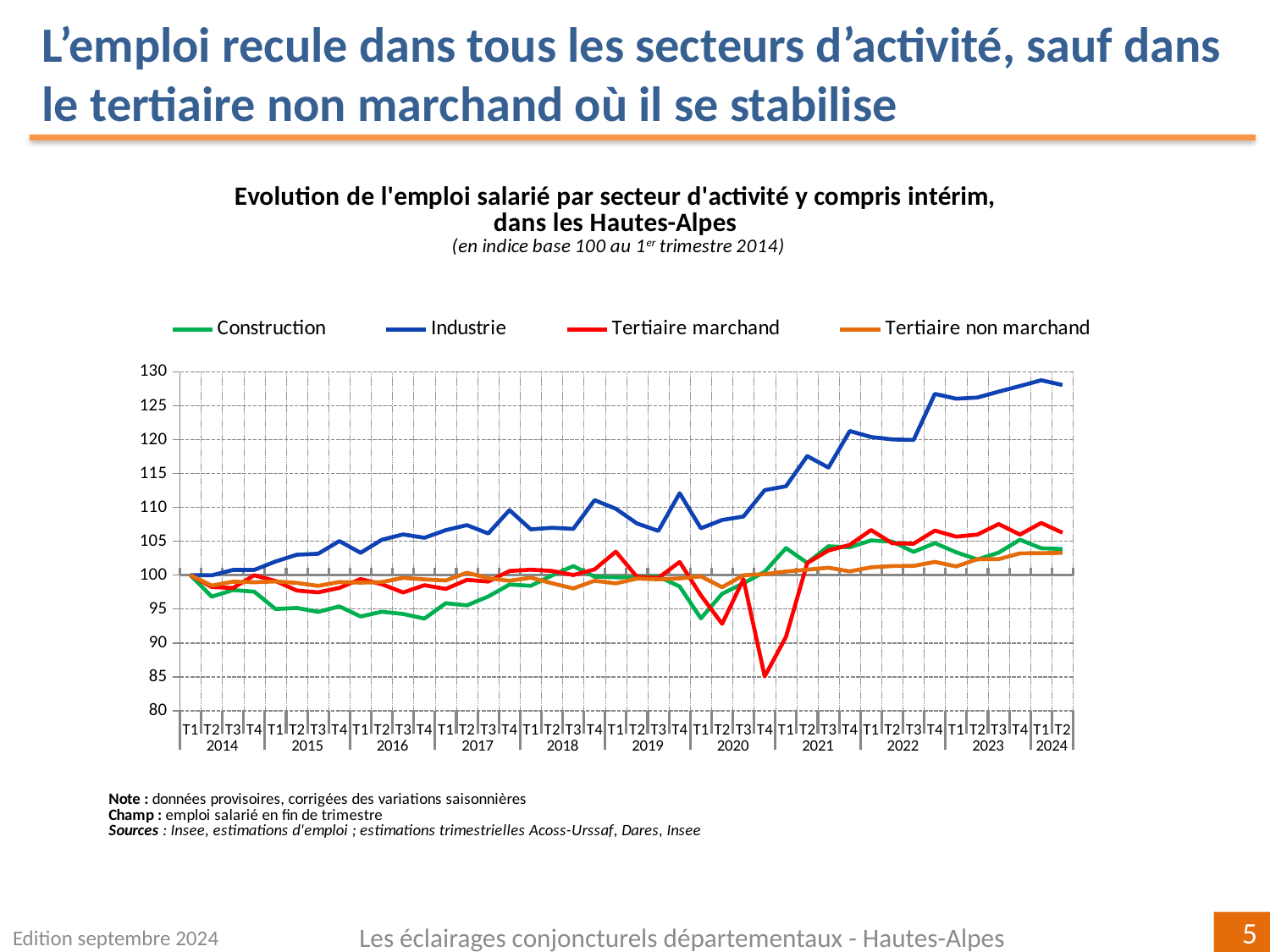
At T2 2024, which is larger: the value for Industrie or the value for Construction? Industrie Which colour is used for the Tertiaire non marchand series? orange Which series has the highest value at T2 2024? Industrie How many series does the legend list? 4 Which series has the lowest value at T4 2020? Tertiaire marchand Is the value for Tertiaire marchand at T4 2020 greater or less than 90? less Does the Industrie series generally rise or fall from 2014 to 2024? rise Is the value for Industrie at T2 2024 greater or less than 125? greater What kind of chart is shown on the slide? line chart What is the value of the Industrie series at T1 2014? 100 Is the value for Construction at T1 2020 greater or less than 95? less How many years are labelled on the x axis? 11